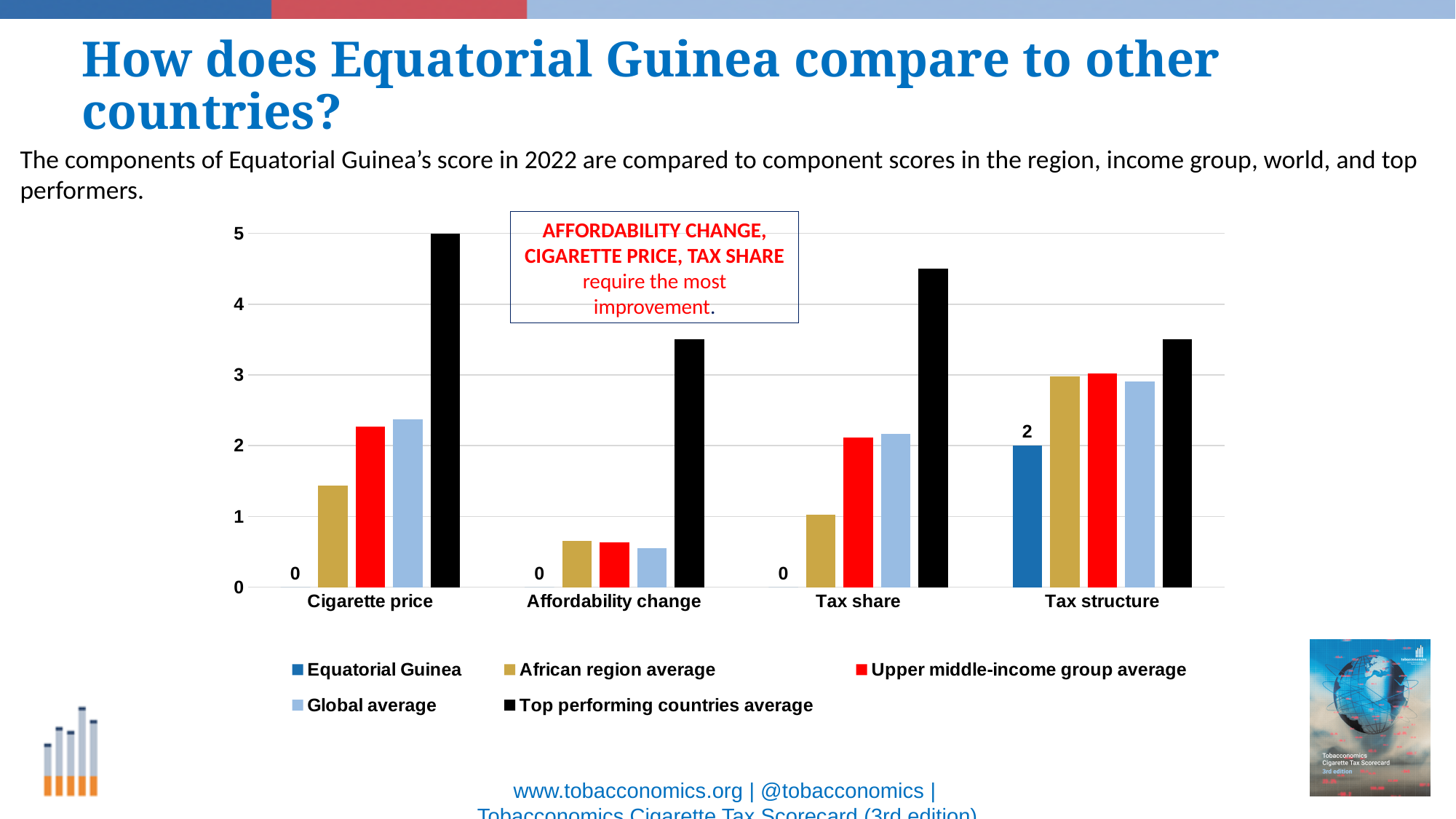
What is the value for Top performing countries average in the Cigarette price category? 5 What colour represents Top performing countries average in the legend? Black Is the value for Top performing countries average in the Tax share category greater or less than 4? greater Is the value for Global average in the Affordability change category greater or less than 1? less What is the value for Equatorial Guinea in the Tax structure category? 2 In which category does Equatorial Guinea have its highest value? Tax structure How many series does the legend list? 5 Is the value for African region average in the Cigarette price category greater or less than 1? greater What kind of chart is shown on the slide? Bar chart How many categories are shown on the x axis of the chart? 4 In the Tax structure category, which is larger: Equatorial Guinea or African region average? African region average What is the value for Equatorial Guinea in the Cigarette price category? 0